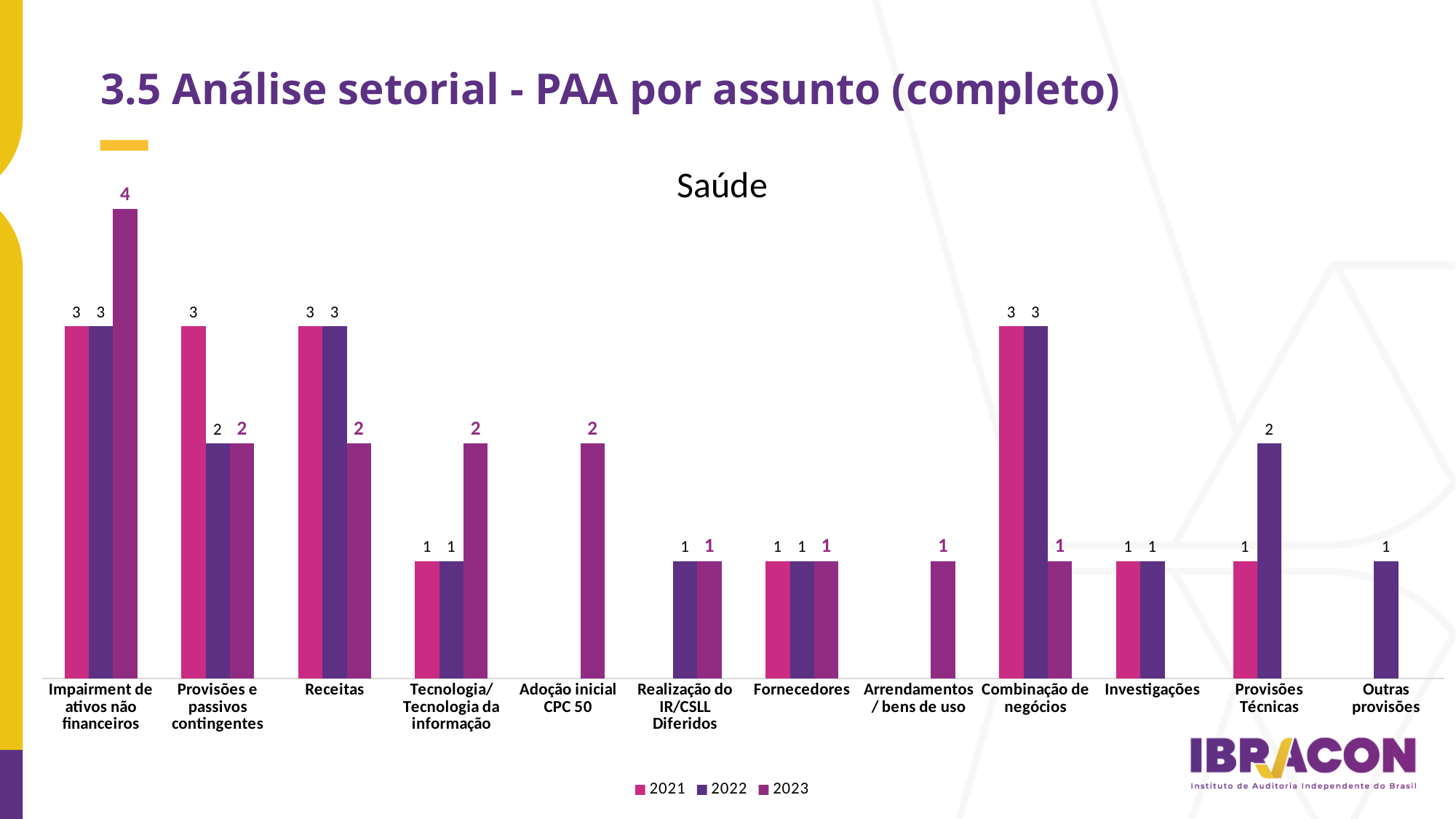
What is the difference between the 2023 and 2021 values in the Impairment de ativos não financeiros category? 1 What kind of chart is shown on the slide? Bar chart What is the difference between the 2021 and 2023 values in the Combinação de negócios category? 2 How many series does the legend list? 3 What is the value for 2021 in the Combinação de negócios category? 3 How many categories are shown on the x axis? 12 What is the value for 2023 in the Adoção inicial CPC 50 category? 2 What is the value for 2023 in the Impairment de ativos não financeiros category? 4 What is the value for 2022 in the Provisões Técnicas category? 2 Which is larger in the Receitas category: the 2022 value or the 2023 value? 2022 What is the title of the chart? Saúde Which category has the highest value for the 2023 series? Impairment de ativos não financeiros